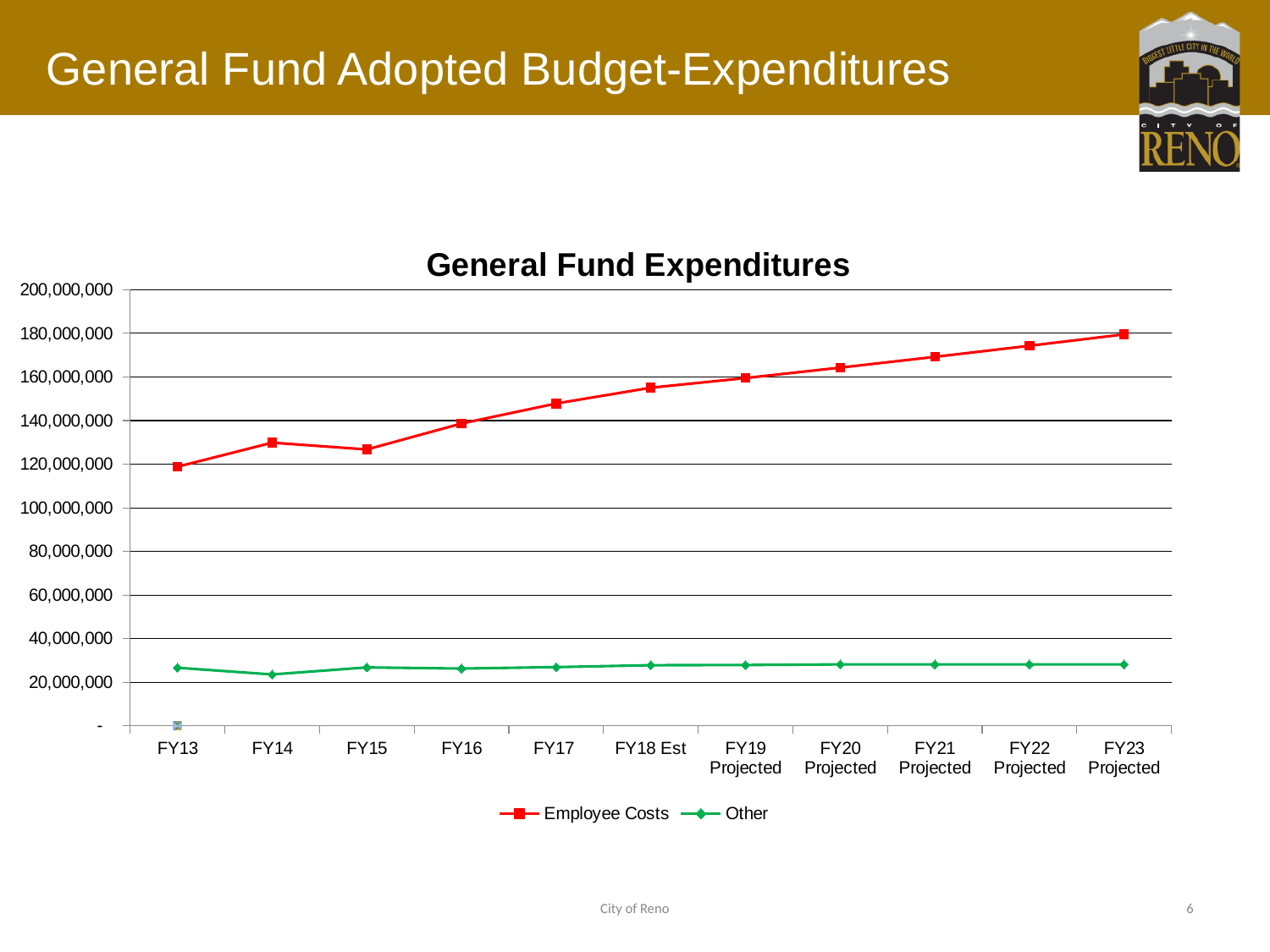
Is the Employee Costs value for FY22 Projected greater or less than 180,000,000? less Is the Other value for FY23 Projected greater or less than 40,000,000? less In which fiscal year is the Employee Costs series at its highest? FY23 Projected Does the Employee Costs series generally rise or fall from FY13 to FY23 Projected? rise How many fiscal-year points are plotted along the x axis of the General Fund Expenditures chart? 11 What kind of chart is shown on the slide? line chart Is the Employee Costs value for FY14 greater or less than 120,000,000? greater In which fiscal year is the Employee Costs series at its lowest? FY13 Which series is larger in FY13, Employee Costs or Other? Employee Costs How many series does the legend of the General Fund Expenditures chart list? 2 In which fiscal year is the Other series at its lowest? FY14